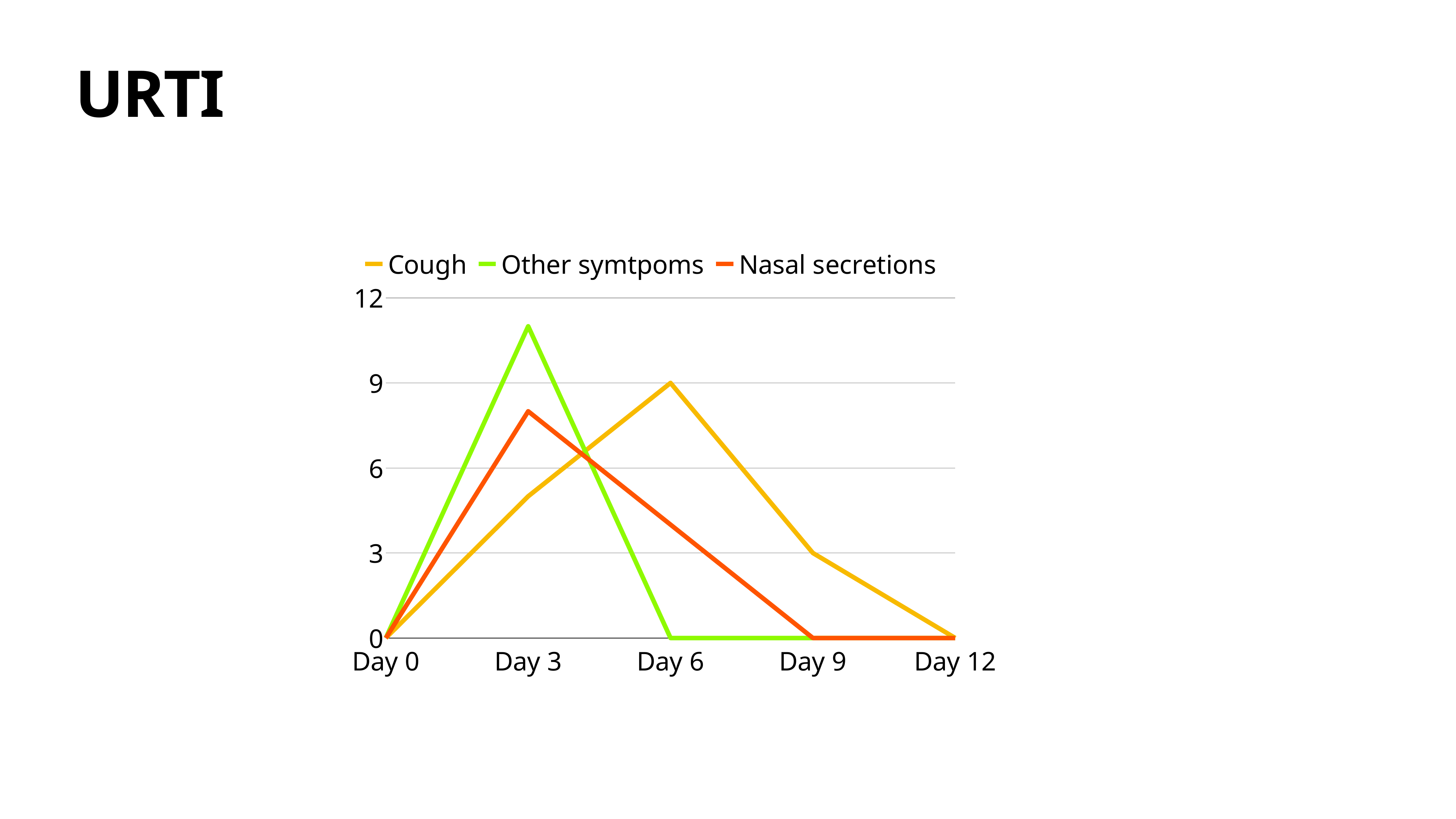
Is the value for Other symtpoms at Day 3 greater or less than 9? greater How many day points are shown on the x axis? 5 How many series does the legend list? 3 Is the value for Cough at Day 3 greater or less than 6? less What is the value for Other symtpoms at Day 6? 0 What is the value for Cough at Day 9? 3 On which day does the Cough series reach its peak? Day 6 What is the value for Cough at Day 6? 9 Which series has the highest value at Day 3? Other symtpoms What kind of chart is shown on the slide? line chart At Day 6, which is larger: Cough or Nasal secretions? Cough